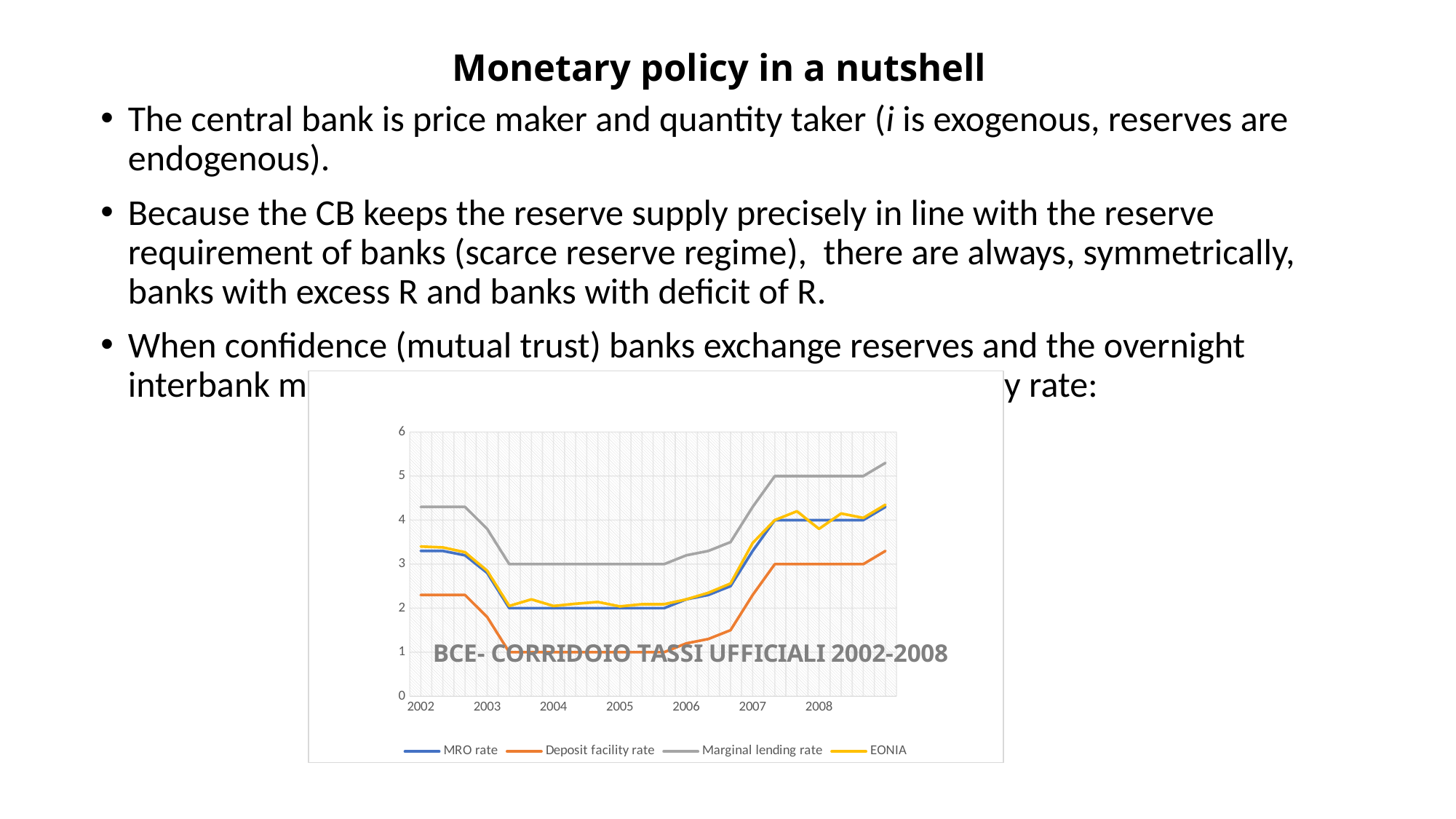
Does the Deposit facility rate rise or fall between 2002 and 2004? fall How many series does the chart's legend list? 4 Which series has the highest values across the whole chart? Marginal lending rate Which series is drawn in grey in the chart? Marginal lending rate What kind of chart is shown on the slide? line chart In 2002, which is higher: the Marginal lending rate or the Deposit facility rate? Marginal lending rate Is the Deposit facility rate at the right end of the chart greater or less than 3? greater What is the title of the chart? BCE- CORRIDOIO TASSI UFFICIALI 2002-2008 Is the Deposit facility rate in 2002 greater or less than 2? greater Is the Marginal lending rate at the right end of the chart greater or less than 5? greater Which series has the lowest values across the whole chart? Deposit facility rate